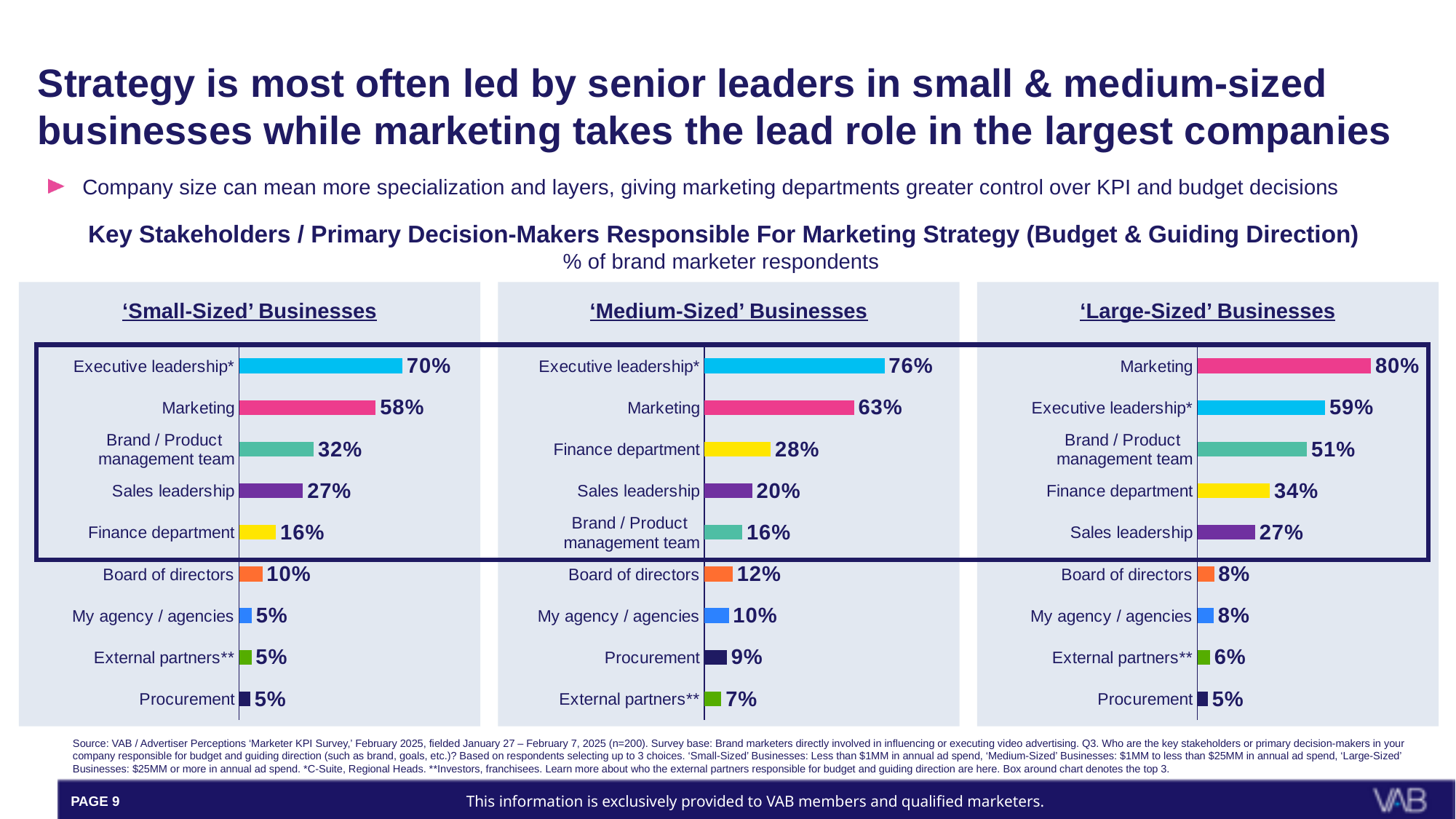
How many categories are shown in the 'Small-Sized' Businesses chart? 9 In the 'Medium-Sized' Businesses chart, what percentage is shown for Finance department? 28% In the 'Medium-Sized' Businesses chart, which category has the lowest value? External partners** In the 'Medium-Sized' Businesses chart, which is larger: Sales leadership or Brand / Product management team? Sales leadership In the 'Large-Sized' Businesses chart, what percentage is shown for Procurement? 5% In the 'Large-Sized' Businesses chart, what is the difference between Marketing and Executive leadership*? 21% In the 'Small-Sized' Businesses chart, what percentage is shown for Executive leadership*? 70% In the 'Large-Sized' Businesses chart, which category has the highest value? Marketing What type of chart is used for the 'Medium-Sized' Businesses data? Bar chart What is the subtitle under the main chart title describing the unit of measurement? % of brand marketer respondents In the 'Small-Sized' Businesses chart, what is the difference between Executive leadership* and Marketing? 12% In the 'Large-Sized' Businesses chart, what percentage is shown for Brand / Product management team? 51%